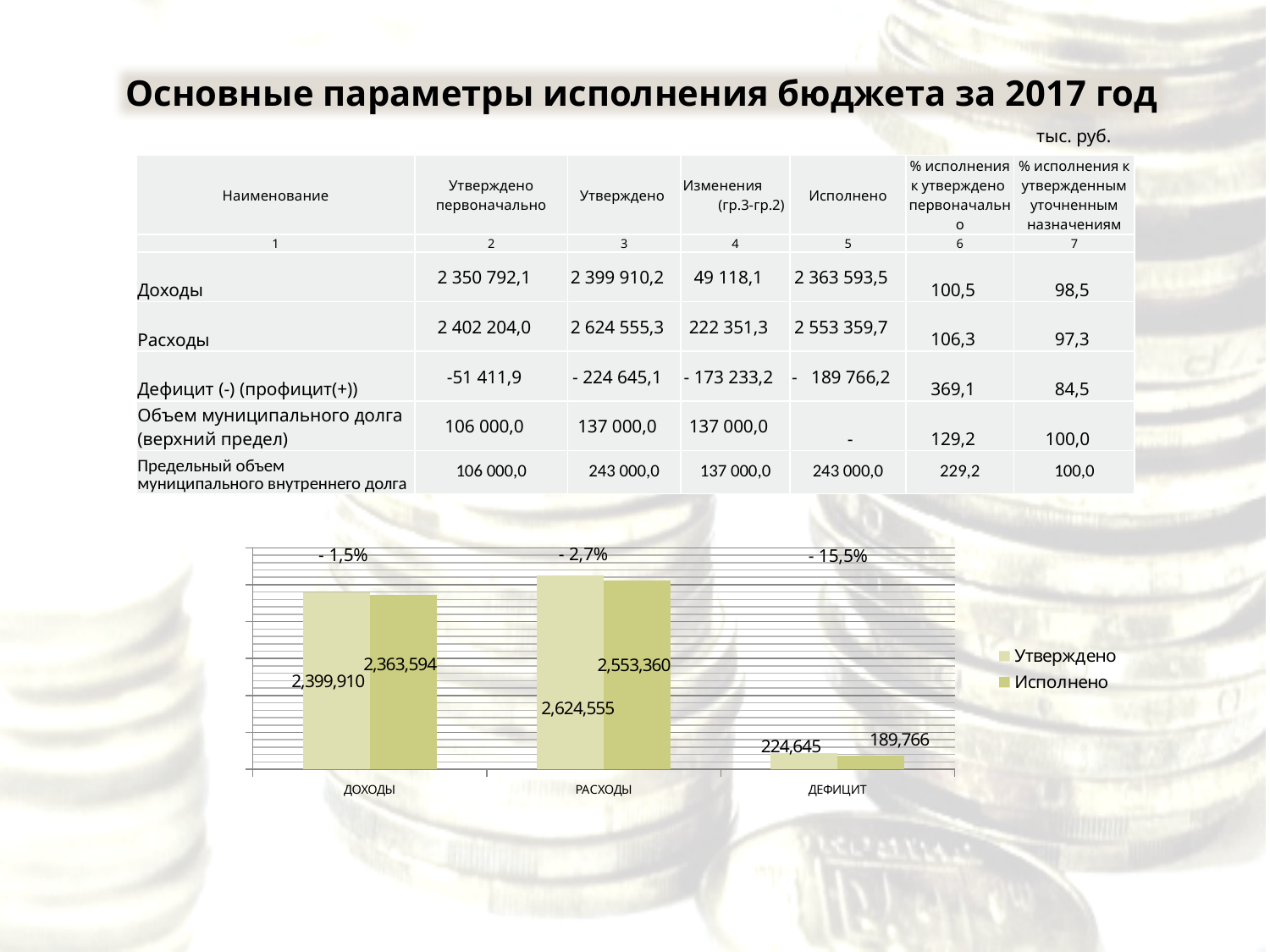
What type of chart is shown on the slide? Bar chart In the bar chart, what is the difference between the Утверждено and Исполнено values for ДОХОДЫ? 36,316 How many categories are shown on the x axis of the bar chart? 3 What is the Исполнено value for РАСХОДЫ in the bar chart? 2,553,360 In the bar chart, what is the difference between the Утверждено and Исполнено values for РАСХОДЫ? 71,195 Which category has the lowest Исполнено value in the bar chart? ДЕФИЦИТ In the bar chart, which is larger for РАСХОДЫ: the Утверждено value or the Исполнено value? Утверждено What is the Утверждено value for ДОХОДЫ in the bar chart? 2,399,910 How many series does the legend of the bar chart list? 2 Which category has the highest Утверждено value in the bar chart? РАСХОДЫ What is the Исполнено value for ДЕФИЦИТ in the bar chart? 189,766 What is the Утверждено value for ДЕФИЦИТ in the bar chart? 224,645